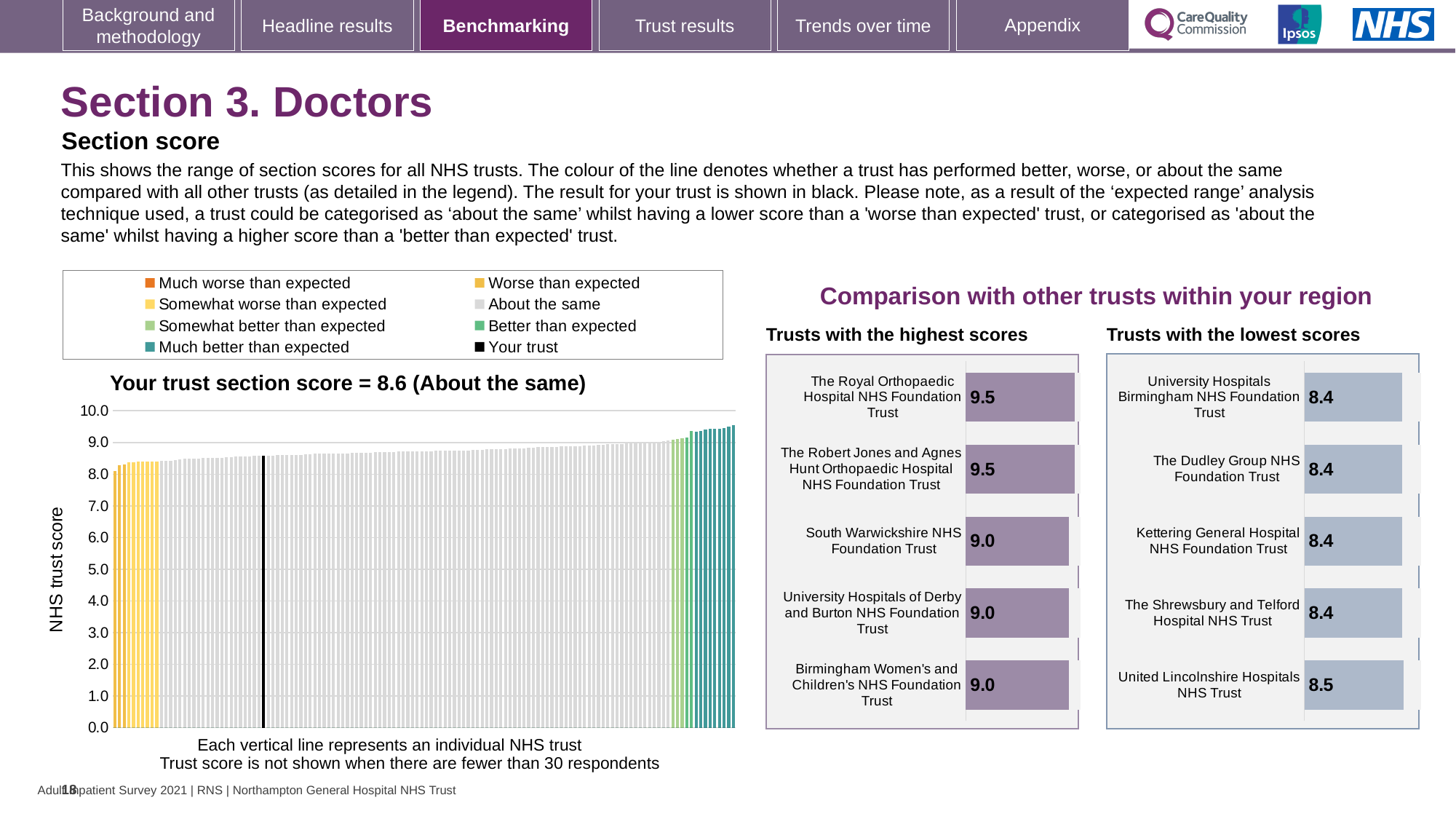
In the 'Trusts with the lowest scores' chart, what is the score for Kettering General Hospital NHS Foundation Trust? 8.4 In the 'Trusts with the highest scores' chart, how many trusts are listed? 5 In the main chart 'Your trust section score', which category does your trust fall into? About the same What kind of chart is the main chart showing the range of section scores for all NHS trusts? bar chart In the main chart 'Your trust section score', what is the section score for your trust? 8.6 How many entries does the legend above the main chart list? 8 In the 'Trusts with the highest scores' chart, what is the score for The Royal Orthopaedic Hospital NHS Foundation Trust? 9.5 In the main chart, is the highest trust score greater or less than 9.0? greater In the 'Trusts with the lowest scores' chart, which trust has the highest score? United Lincolnshire Hospitals NHS Trust In the 'Trusts with the highest scores' chart, what is the difference between the scores of The Royal Orthopaedic Hospital NHS Foundation Trust and South Warwickshire NHS Foundation Trust? 0.5 In the main chart, do the trust scores rise or fall from left to right along the x axis? rise In the 'Trusts with the lowest scores' chart, what is the score for United Lincolnshire Hospitals NHS Trust? 8.5